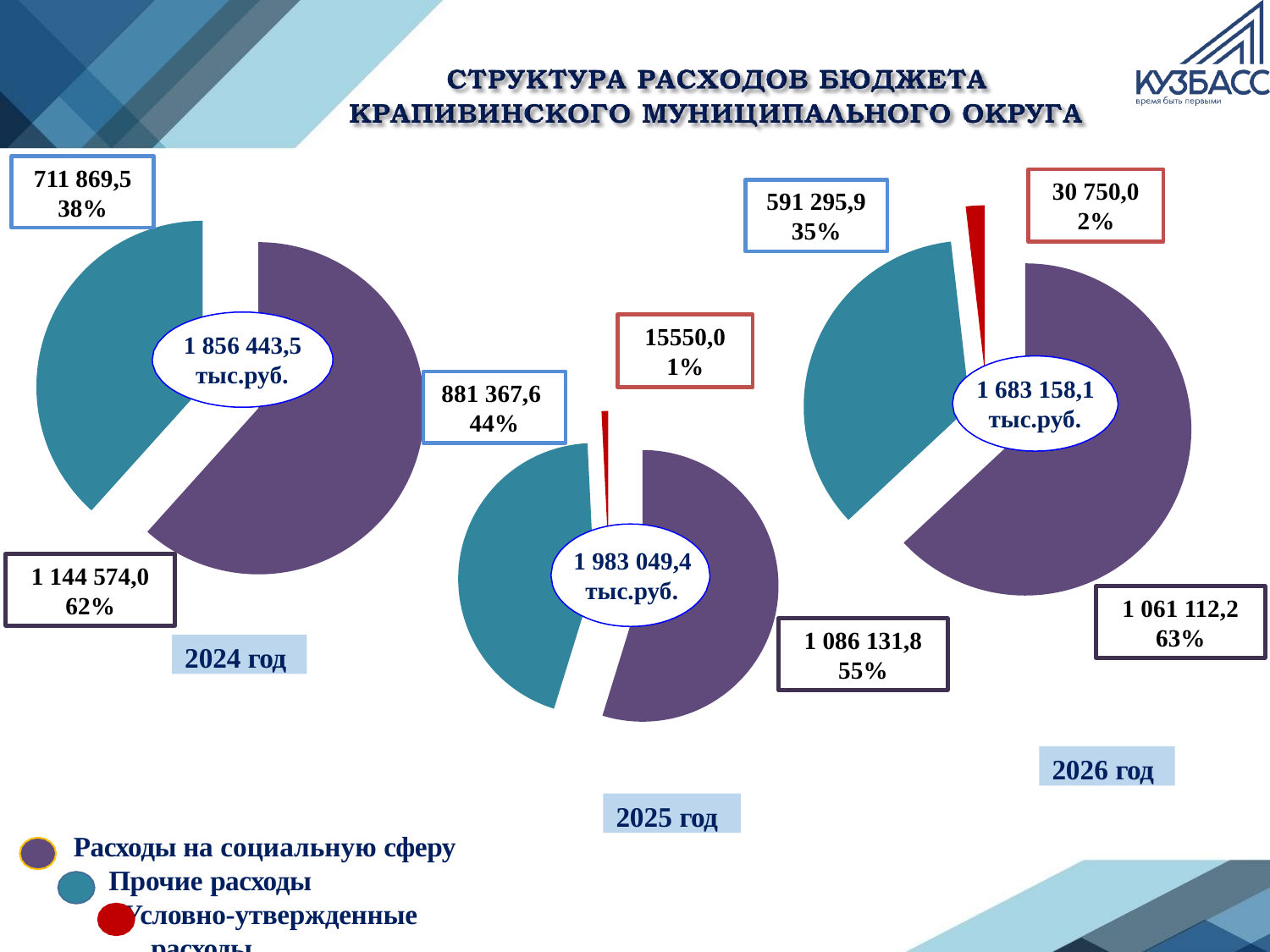
In the 2025 год chart, what is the value for Условно-утвержденные расходы? 15550,0 In the 2026 год chart, what is the value for Прочие расходы? 591 295,9 In the 2025 год chart, which category is the largest? Расходы на социальную сферу In the 2026 год chart, what is the difference between the shares of Расходы на социальную сферу and Прочие расходы? 28% How many categories does the legend list? 3 What kind of charts are shown on the slide? Pie charts What total is shown in the centre of the 2025 год chart? 1 983 049,4 тыс.руб. In the 2026 год chart, which category is the smallest? Условно-утвержденные расходы In the 2025 год chart, what share of the pie is Расходы на социальную сферу? 55% In the 2024 год chart, what is the value for Расходы на социальную сферу? 1 144 574,0 In the 2024 год chart, what share of the pie is Прочие расходы? 38% How many pie charts are on the slide? 3